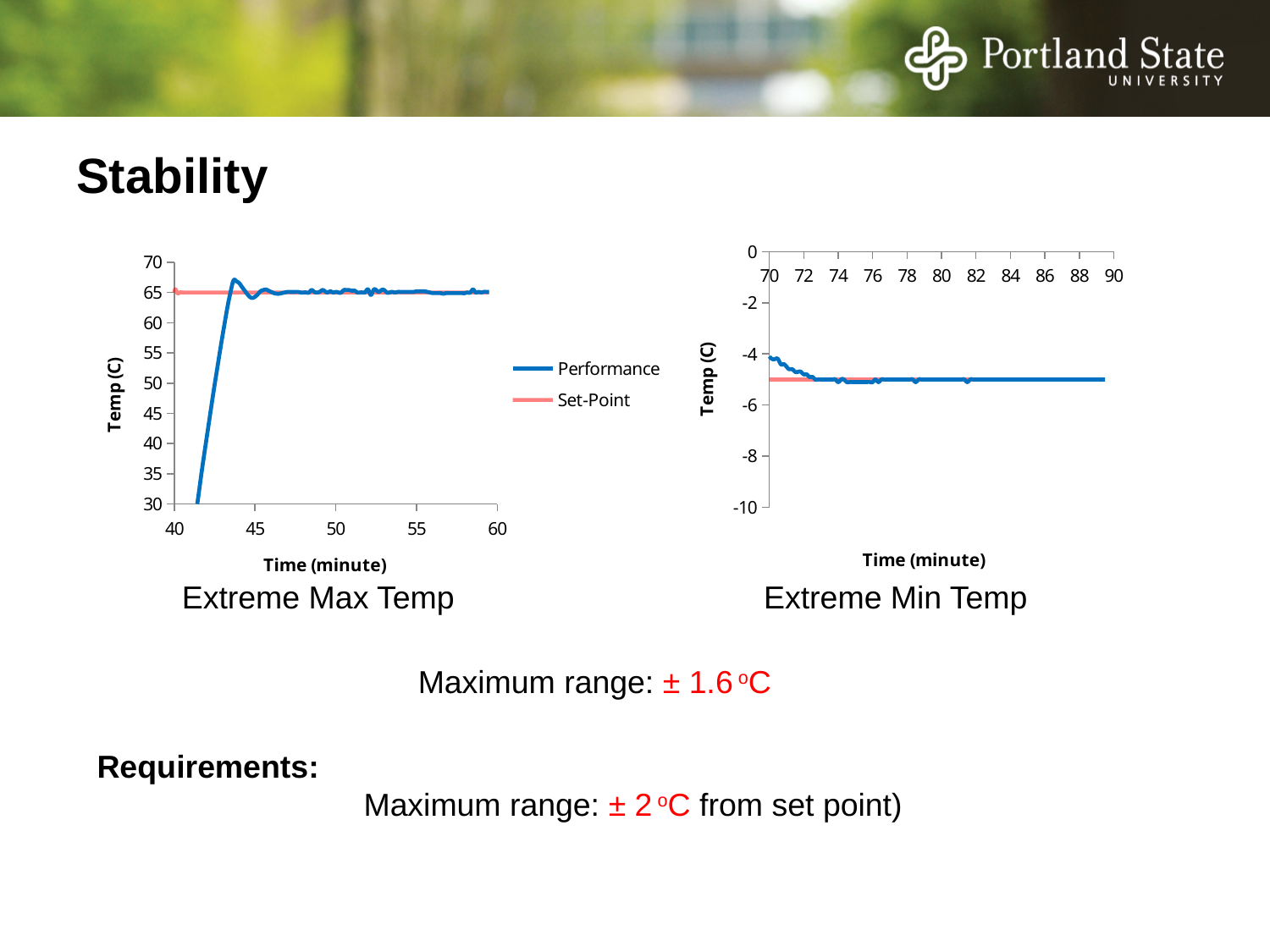
In the Extreme Max Temp chart, is the highest point of the Performance line greater or less than 65? greater What kind of chart is the Extreme Max Temp chart? line chart In the Extreme Min Temp chart, is the Performance value at minute 85 greater or less than -6? greater What is the x-axis title of the Extreme Min Temp chart? Time (minute) In the Extreme Min Temp chart, is the Set-Point value greater or less than -4? less In the Extreme Max Temp chart, what value does the Set-Point line sit at on the Temp (C) axis? 65 What are the two series named in the legend of the Extreme Max Temp chart? Performance and Set-Point How many series does the legend list for the Extreme Max Temp chart? 2 In the Extreme Max Temp chart, does the Performance line rise or fall between minute 42 and minute 44? rise In the Extreme Min Temp chart, does the Performance line rise or fall between minute 70 and minute 73? fall